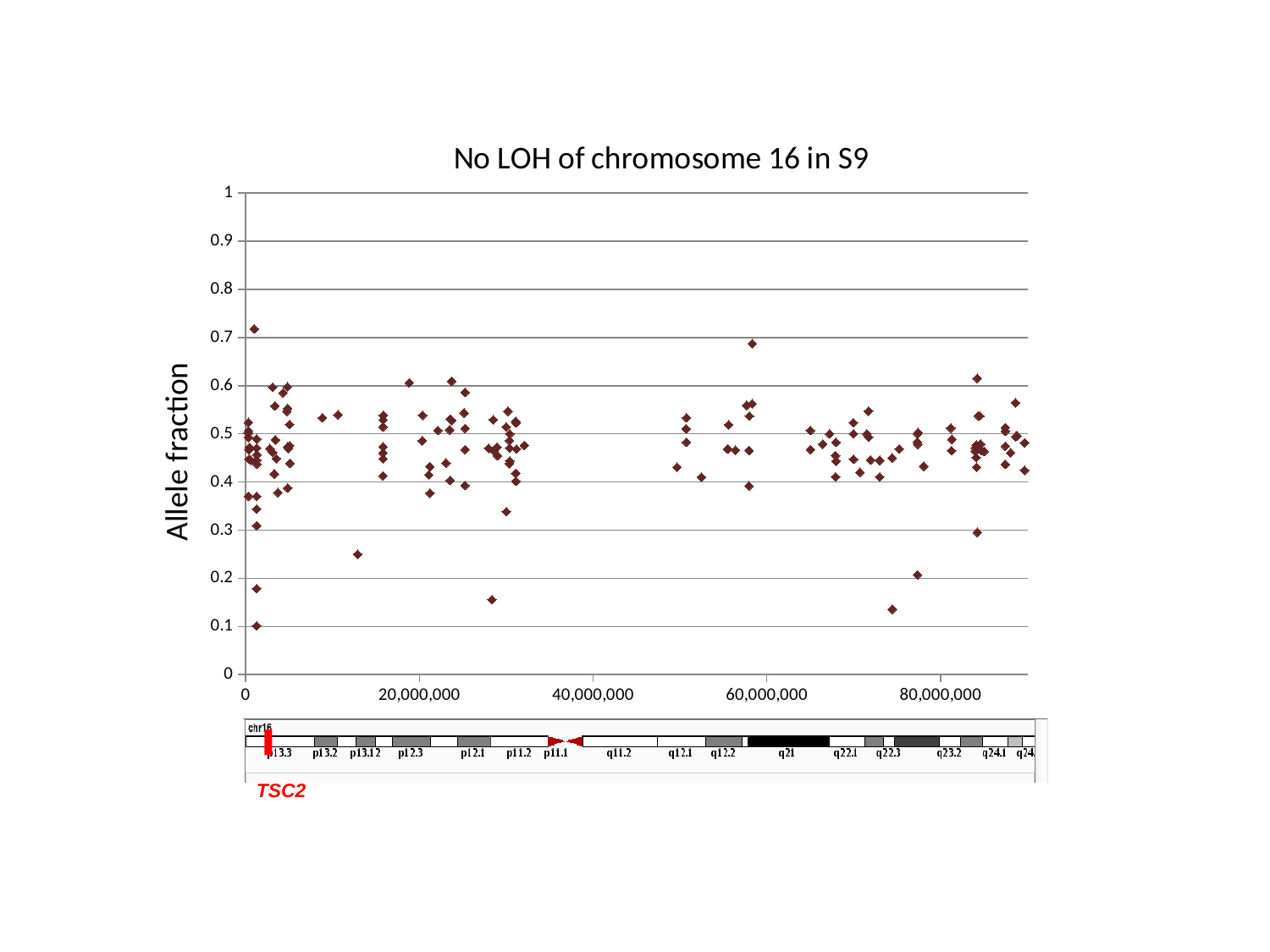
Is the lowest point near 75,000,000 on the x axis greater or less than 0.2? less Is the lowest plotted allele fraction greater or less than 0.2? less Is the lowest point near 28,000,000 on the x axis greater or less than 0.2? less What is the title of the chart? No LOH of chromosome 16 in S9 What kind of chart is shown on the slide? scatter plot What is the label on the y axis of the chart? Allele fraction